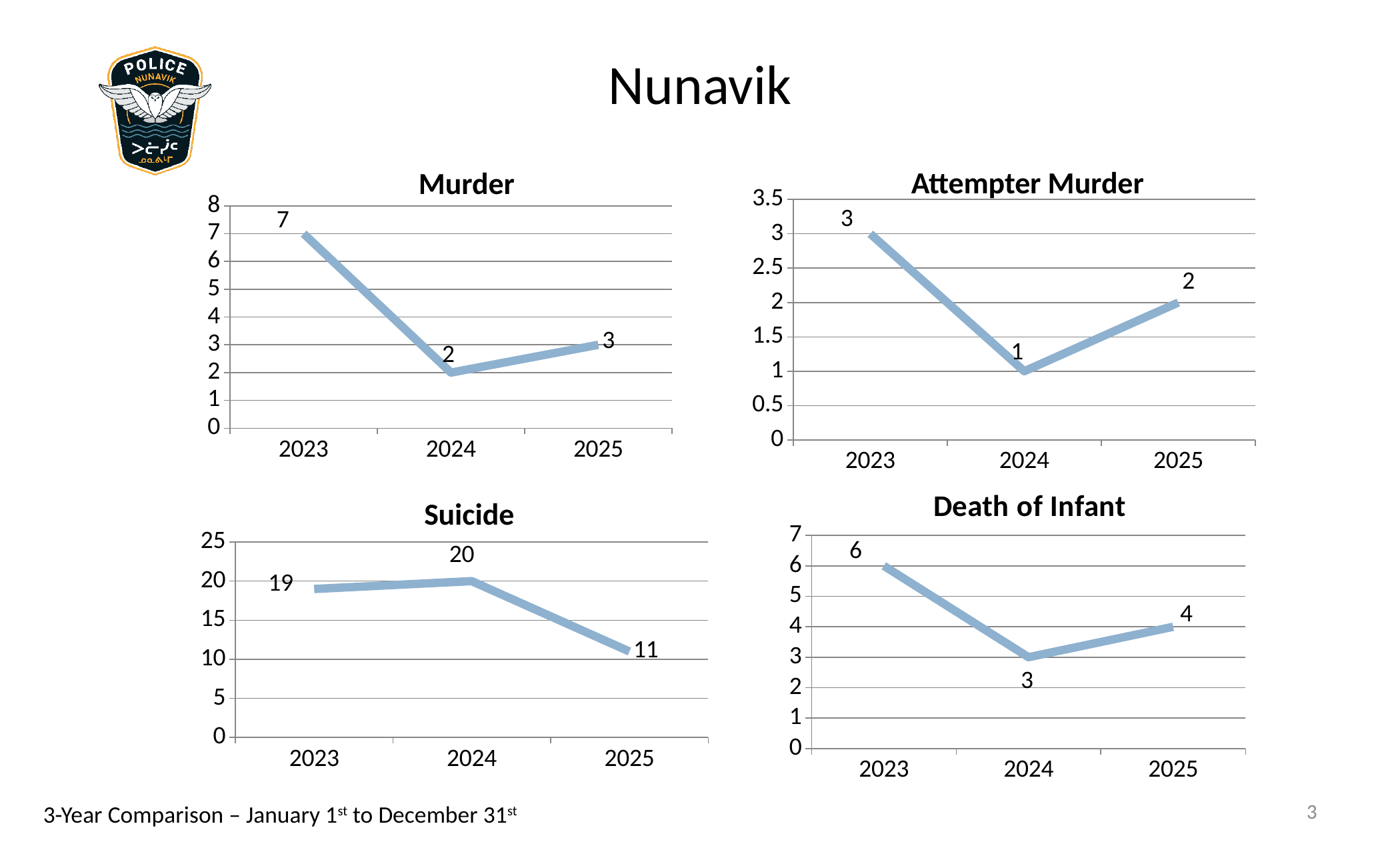
In the Death of Infant chart, do the values rise or fall from 2023 to 2024? fall In the Suicide chart, what is the difference between the 2024 and 2025 values? 9 In the Suicide chart, which is larger, the value for 2023 or the value for 2024? 2024 In the Death of Infant chart, what is the value for 2024? 3 In the Attempter Murder chart, what is the value for 2025? 2 In the Attempter Murder chart, which year has the highest value? 2023 In the Suicide chart, what is the value for 2025? 11 In the Murder chart, what is the difference between the 2023 and 2025 values? 4 In the Murder chart, what is the value for 2023? 7 How many years are plotted in the Suicide chart? 3 In the Murder chart, which year has the lowest value? 2024 What kind of chart is the Murder chart? line chart